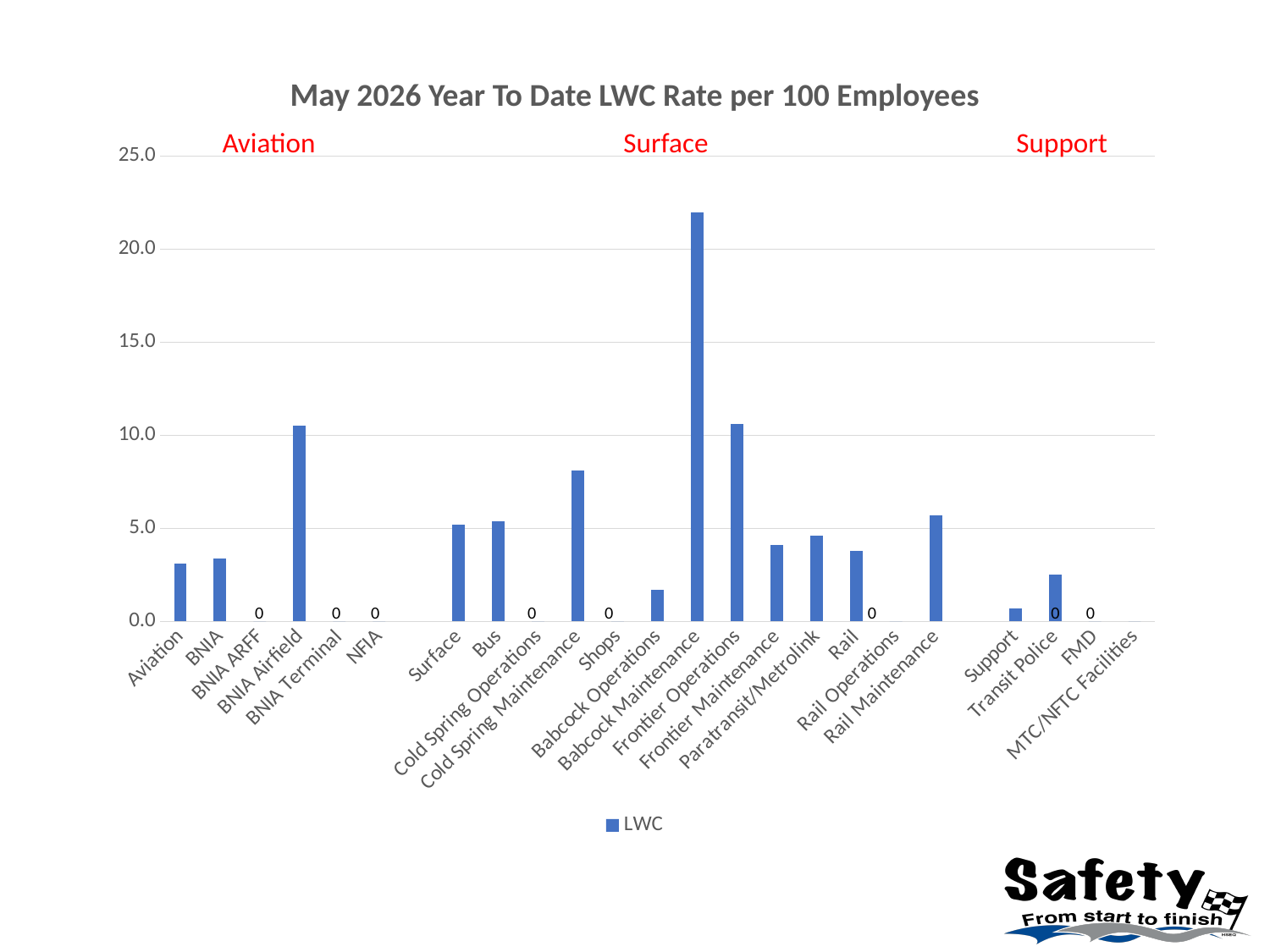
Is the value for Babcock Maintenance greater or less than 20.0? greater What is the LWC rate for Shops? 0 How many categories are shown on the x axis? 23 What is the title of the chart? May 2026 Year To Date LWC Rate per 100 Employees Which category has the highest LWC rate? Babcock Maintenance What type of chart is shown on the slide? Bar chart Which is larger, the value for BNIA Airfield or the value for Aviation? BNIA Airfield What is the LWC rate for Rail Operations? 0 What is the LWC rate for BNIA ARFF? 0 Is the value for Aviation greater or less than 5.0? less How many series does the legend list? 1 What are the three red group labels shown above the chart? Aviation, Surface, Support